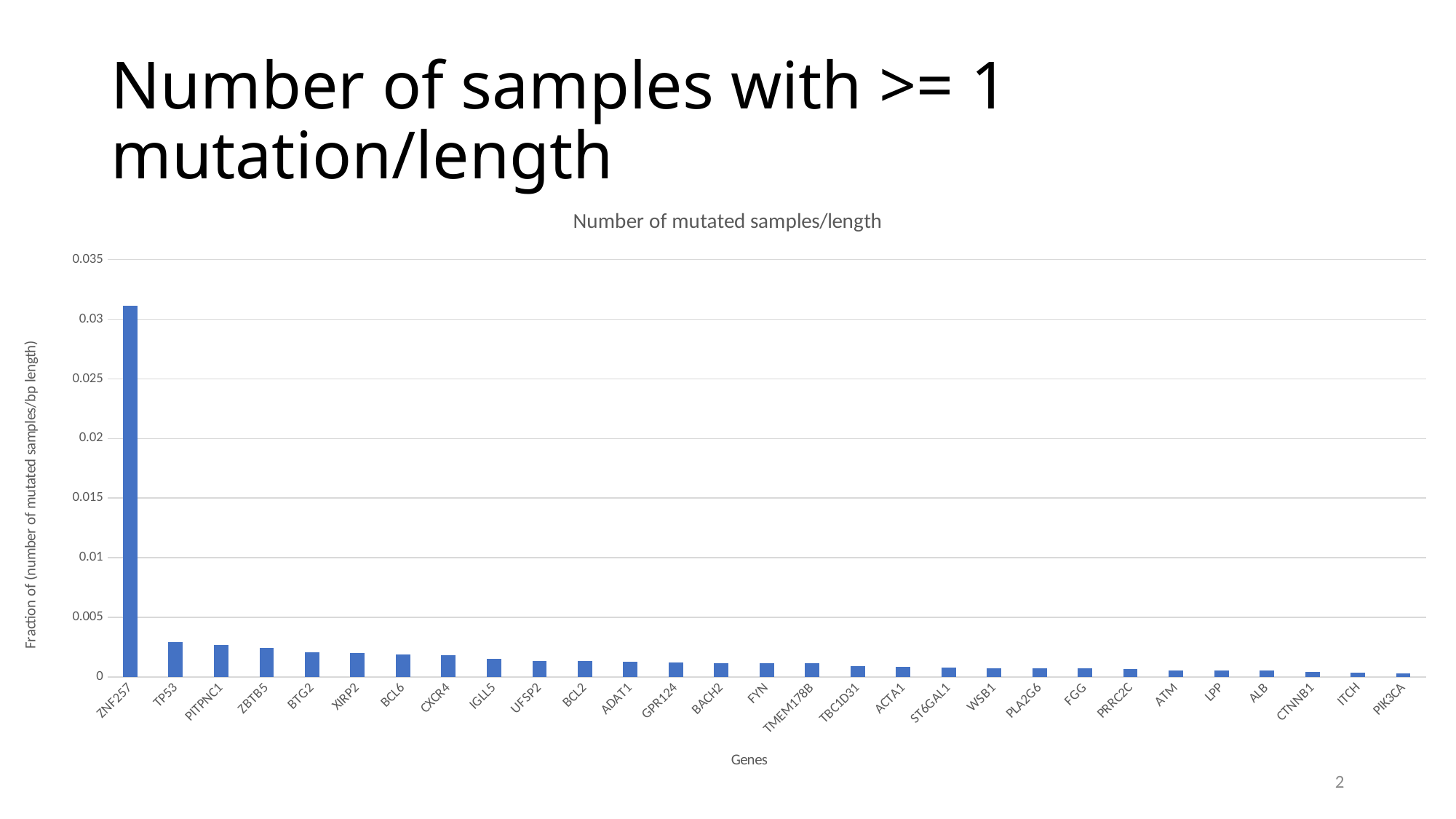
Which has a larger value, BTG2 or ATM? BTG2 What is the label of the x axis of the chart? Genes Is the value for ZNF257 greater or less than 0.025? greater Is the value for PIK3CA greater or less than 0.005? less What is the title of the chart? Number of mutated samples/length Which gene has the highest value in the chart? ZNF257 Do the values rise or fall moving from left to right along the x axis? fall What kind of chart is shown on the slide? bar chart Which has a larger value, ZNF257 or TP53? ZNF257 How many genes are plotted on the x axis of the chart? 29 Is the value for TP53 greater or less than 0.005? less Which has a larger value, TP53 or PIK3CA? TP53